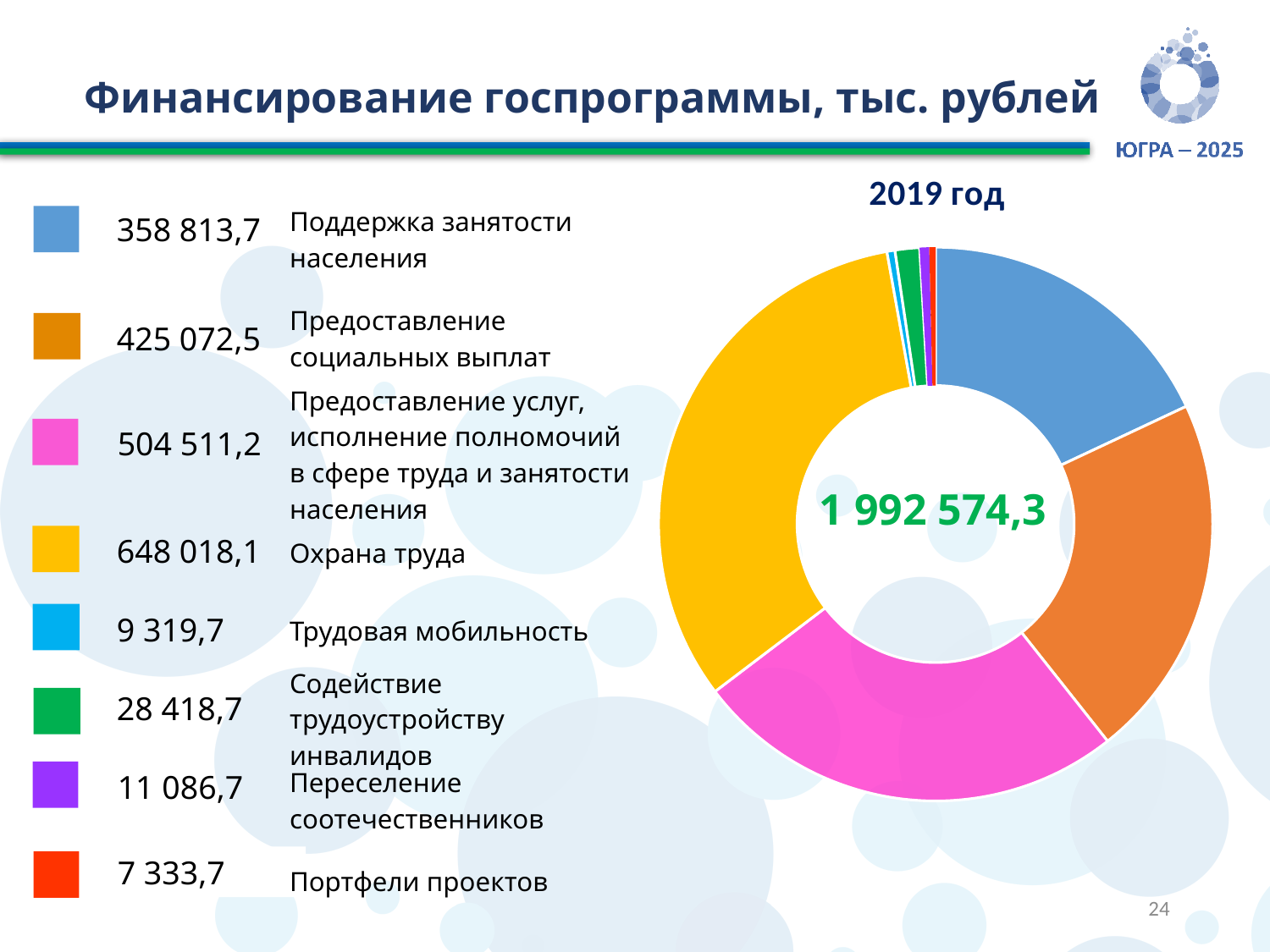
What is the difference between Охрана труда and Предоставление услуг, исполнение полномочий в сфере труда и занятости населения? 143 506,9 How many categories does the chart show? 8 What is the value for Переселение соотечественников? 11 086,7 What is the value for Трудовая мобильность? 9 319,7 Which category has the highest value? Охрана труда What is the value for Охрана труда? 648 018,1 What is the value for Поддержка занятости населения? 358 813,7 Which is larger: Содействие трудоустройству инвалидов or Переселение соотечественников? Содействие трудоустройству инвалидов What total value is shown in the centre of the chart? 1 992 574,3 Which category has the lowest value? Портфели проектов What kind of chart is shown on the slide? Donut (pie) chart What is the difference between Предоставление социальных выплат and Поддержка занятости населения? 66 258,8